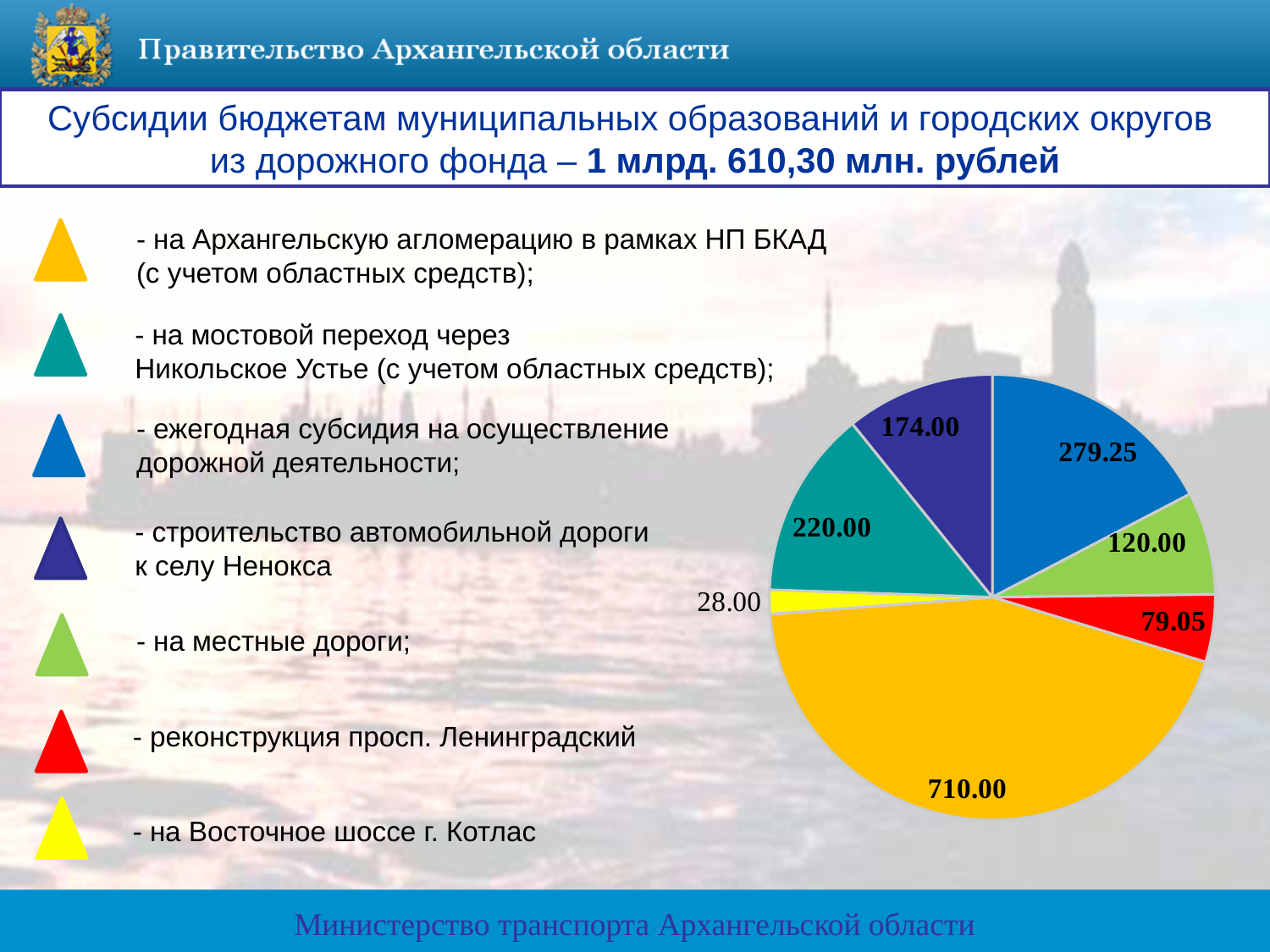
What is the difference between the largest slice (710.00) and the slice for the annual road subsidy (279.25)? 430.75 What value is shown for the bridge crossing over Никольское Устье (мостовой переход)? 220.00 What value is shown for the slice for the annual subsidy for road activities (ежегодная субсидия на осуществление дорожной деятельности)? 279.25 What is the value of the largest slice of the pie chart? 710.00 What kind of chart is shown on the slide? pie chart Which colour represents the Восточное шоссе г. Котлас slice in the pie chart? yellow How many slices does the pie chart have? 7 What value is shown for the road to the village of Ненокса? 174.00 Which is larger: the slice for local roads (местные дороги) or the slice for the road to Ненокса? the road to Ненокса (174.00) What is the value of the smallest slice of the pie chart? 28.00 What value is shown for the reconstruction of просп. Ленинградский? 79.05 What is the difference between the slice for the bridge crossing (220.00) and the slice for the road to Ненокса (174.00)? 46.00